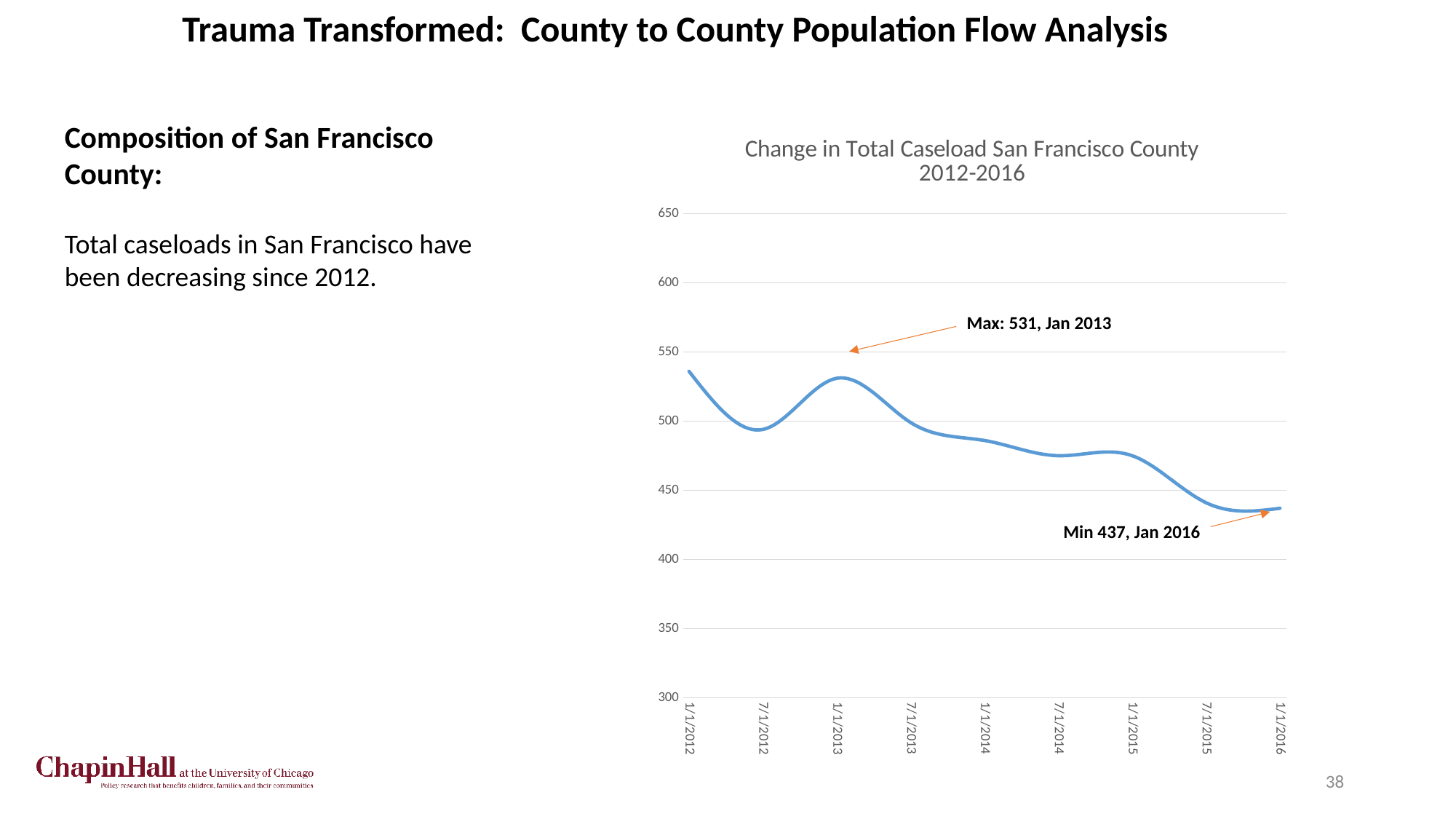
Which is larger, the caseload in Jan 2013 or the caseload in Jan 2016? Jan 2013 In which month and year does the chart mark the maximum caseload? Jan 2013 Is the value for 7/1/2014 greater or less than 500? less What is the title of the chart? Change in Total Caseload San Francisco County 2012-2016 What is the difference between the marked maximum (Jan 2013) and the marked minimum (Jan 2016) caseload? 94 What is the minimum total caseload value marked on the chart? 437 Overall, does the total caseload rise or fall from 2012 to 2016? fall In which month and year does the chart mark the minimum caseload? Jan 2016 How many date labels are shown on the x axis? 9 Is the value for 1/1/2012 greater or less than 500? greater What is the maximum total caseload value marked on the chart? 531 What kind of chart is shown on the slide? line chart